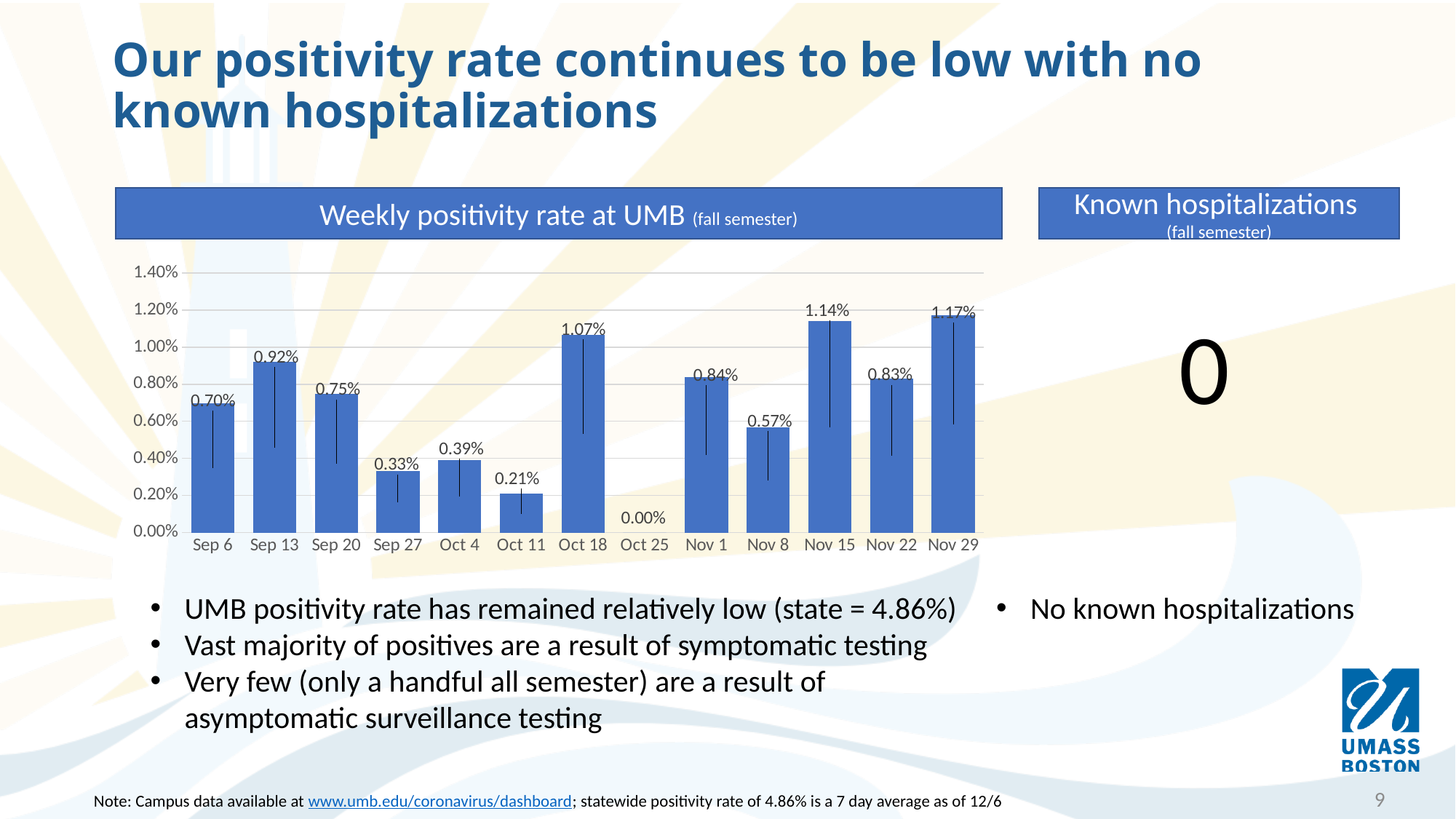
Does the positivity rate rise or fall from Sep 13 to Sep 27? fall What is the difference between the positivity rates for Oct 18 and Oct 11? 0.86% What is the weekly positivity rate at UMB for Sep 13? 0.92% Which week has the highest positivity rate in the Weekly positivity rate at UMB chart? Nov 29 Is the positivity rate for Sep 27 greater or less than 0.40%? less What is the weekly positivity rate at UMB for Nov 8? 0.57% What is the weekly positivity rate at UMB for Oct 18? 1.07% How many weeks are shown on the x axis of the Weekly positivity rate at UMB chart? 13 Which week has a higher positivity rate, Nov 1 or Nov 8? Nov 1 Which week has the lowest positivity rate in the Weekly positivity rate at UMB chart? Oct 25 What kind of chart is used to show the weekly positivity rate at UMB? bar chart What is the title of the chart on the slide? Weekly positivity rate at UMB (fall semester)